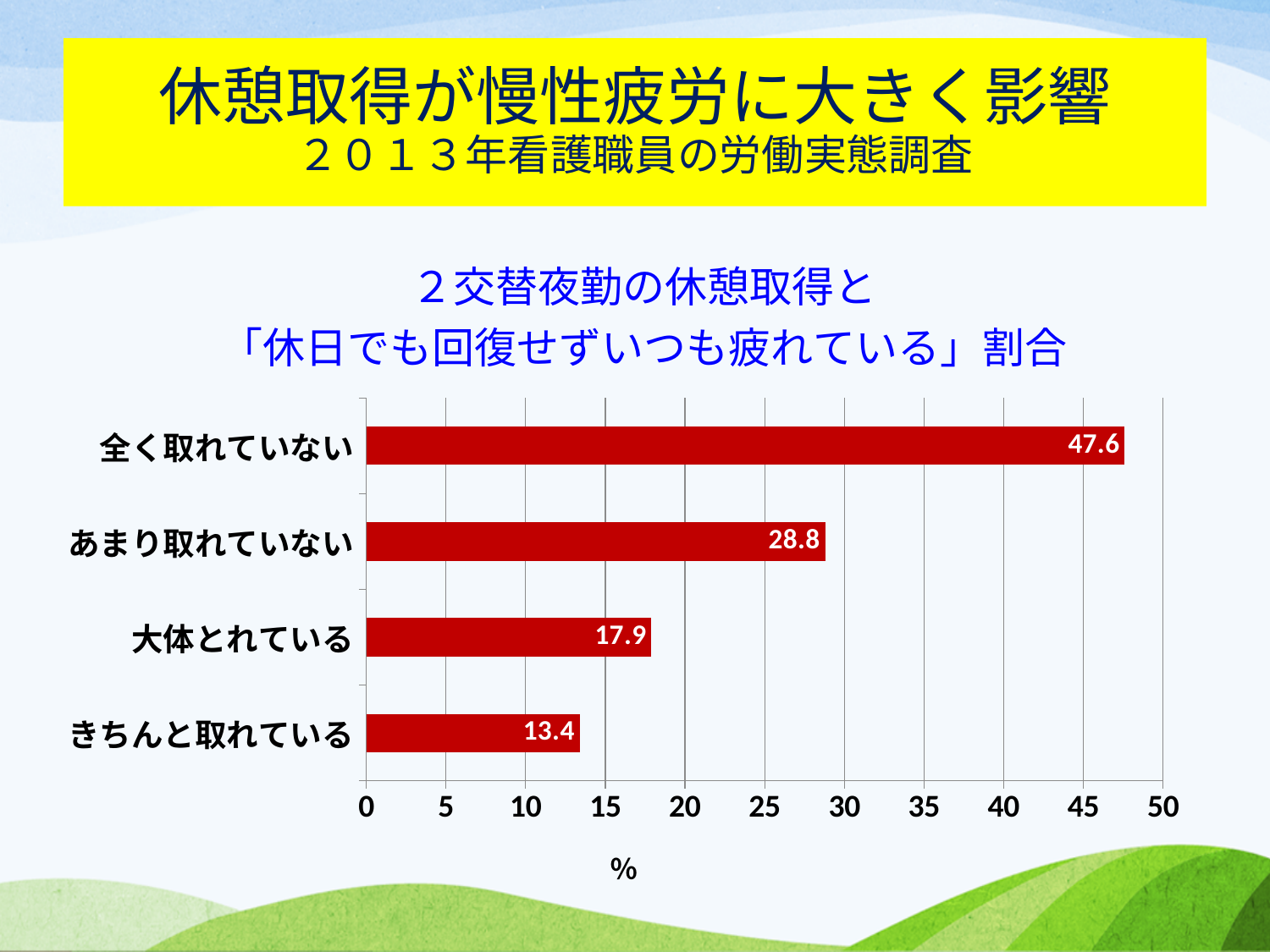
What is the value for あまり取れていない? 28.8 What unit is shown on the horizontal axis of the chart? % Which category has the lowest value? きちんと取れている What is the value for きちんと取れている? 13.4 Which category has the highest value? 全く取れていない What is the difference between the values for 大体とれている and きちんと取れている? 4.5 How many categories are shown in the chart? 4 What is the value for 大体とれている? 17.9 What is the value for 全く取れていない? 47.6 What kind of chart is shown on the slide? Bar chart Which is larger, the value for あまり取れていない or the value for 大体とれている? あまり取れていない What is the difference between the values for 全く取れていない and あまり取れていない? 18.8